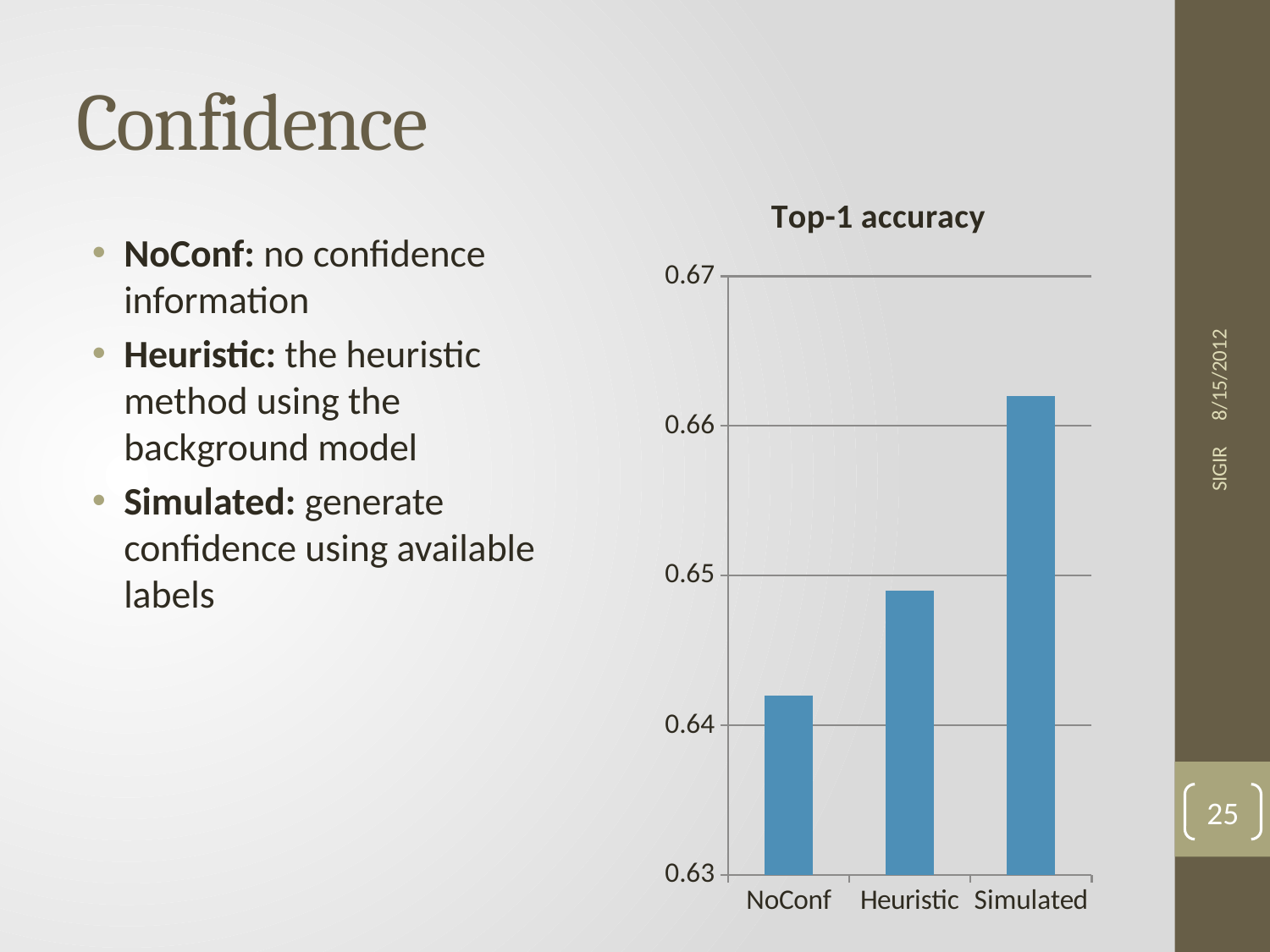
Which has a higher Top-1 accuracy, Heuristic or NoConf? Heuristic What kind of chart is shown on the slide? bar chart What is the title of the chart? Top-1 accuracy What is the lowest value shown on the y axis of the chart? 0.63 How many categories are shown on the x axis of the chart? 3 Which category has the lowest Top-1 accuracy? NoConf Is the value for NoConf greater or less than 0.64? greater Do the values rise or fall from NoConf to Simulated along the x axis? rise Is the value for Heuristic greater or less than 0.65? less Is the value for Simulated greater or less than 0.66? greater Which category has the highest Top-1 accuracy? Simulated